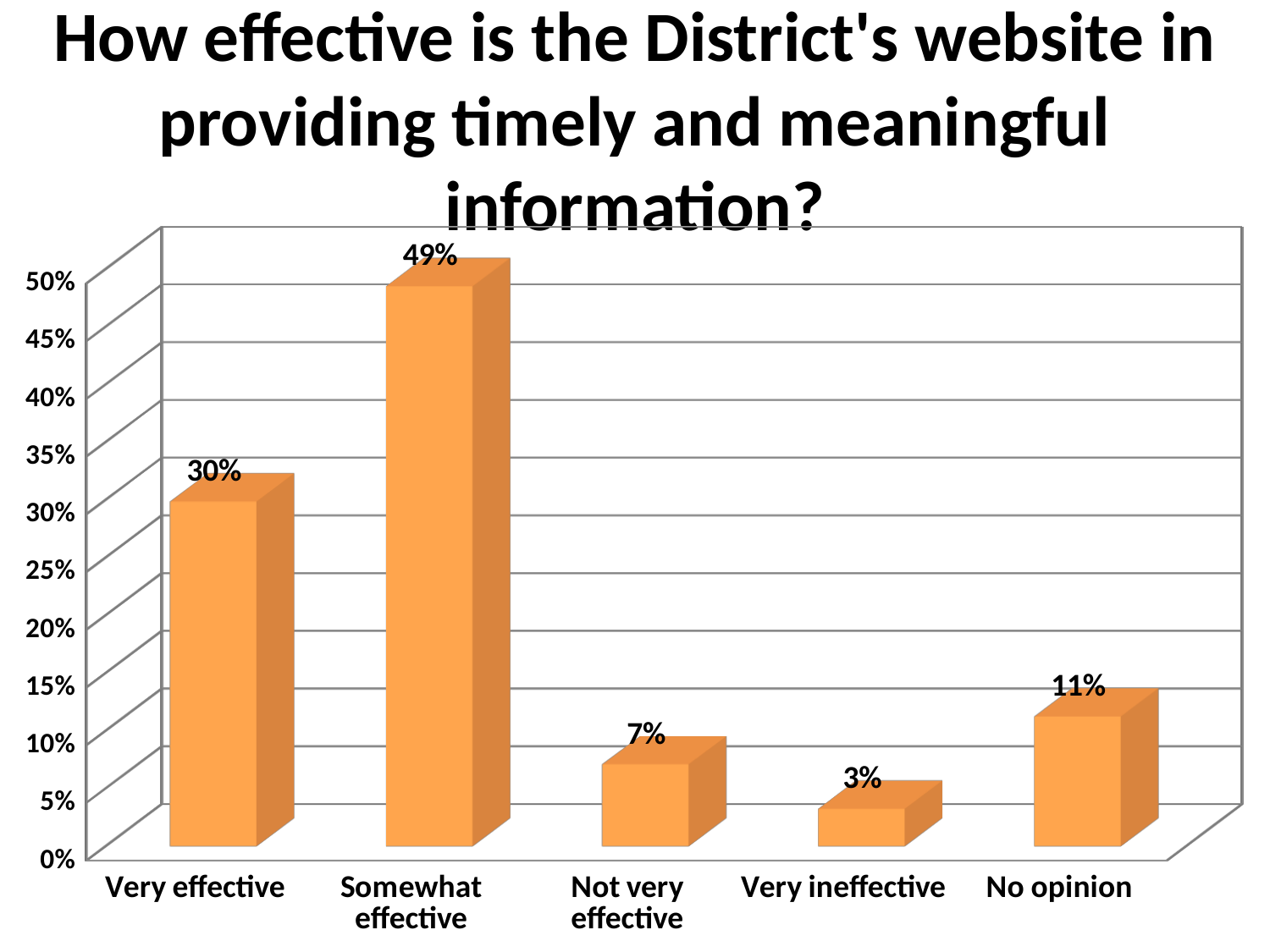
What is the title of the chart? How effective is the District's website in providing timely and meaningful information? What is the value for Very effective? 30% What is the value for Very ineffective? 3% Which category has the highest value? Somewhat effective What is the difference between the values for Somewhat effective and Very effective? 19% How many categories are shown on the x axis? 5 Which category has the lowest value? Very ineffective What is the value for Somewhat effective? 49% Which is larger, the value for Not very effective or the value for No opinion? No opinion What is the difference between the values for No opinion and Not very effective? 4% What kind of chart is this? Bar chart What is the value for No opinion? 11%